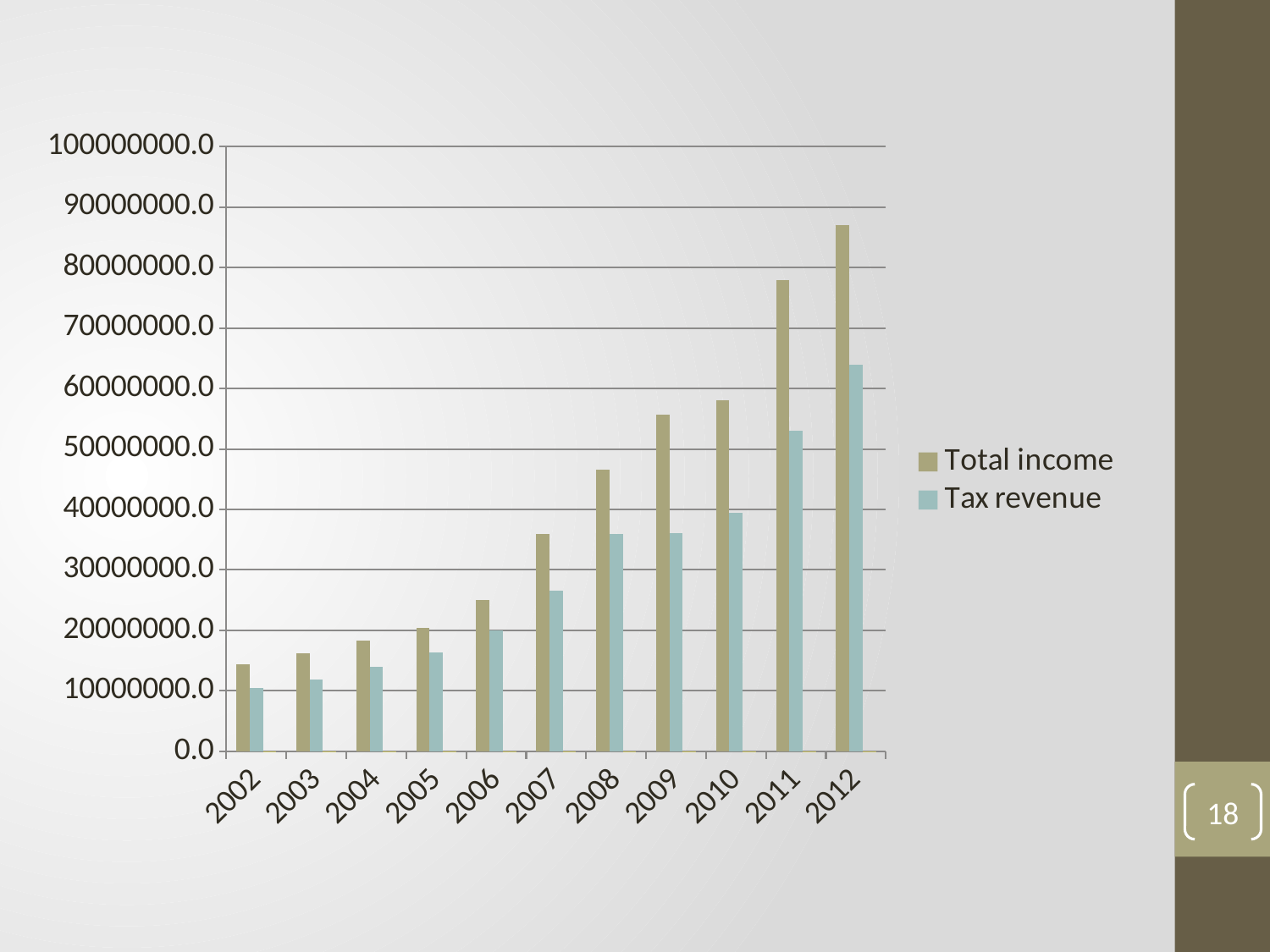
Is the Total income value for 2012 greater or less than 80000000.0? greater How many years are shown on the x axis? 11 What are the two series named in the legend? Total income and Tax revenue Is the Total income value for 2011 greater or less than 80000000.0? less Which year has the lowest Tax revenue? 2002 Is the Tax revenue value for 2011 greater or less than 50000000.0? greater What kind of chart is shown on the slide? bar chart Do the Total income values rise or fall from 2002 to 2012? rise How many series does the legend list? 2 Which year has the highest Total income? 2012 In 2012, which is larger: Total income or Tax revenue? Total income